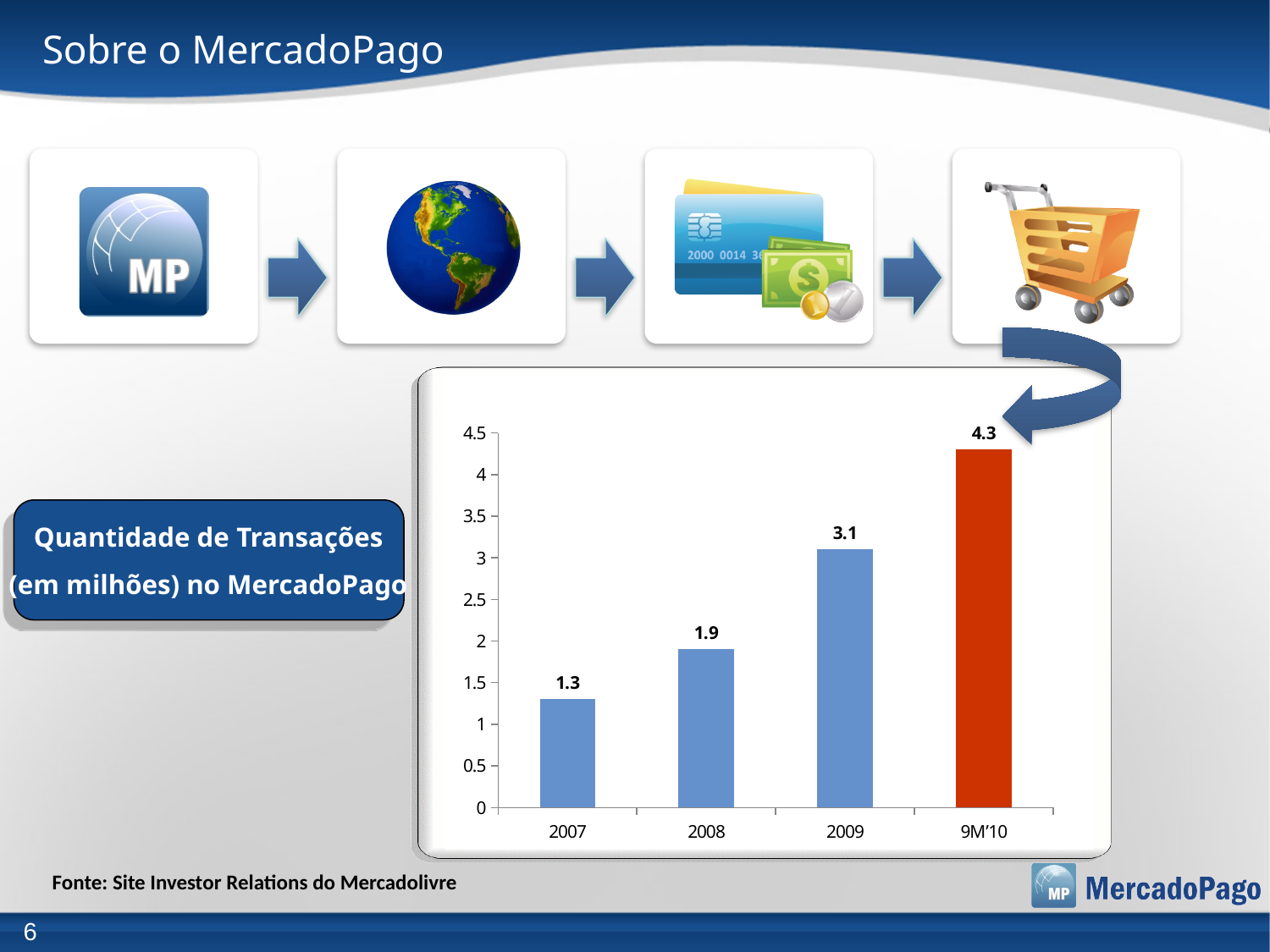
Which is larger, the value for 2009 or the value for 2008? 2009 Do the values rise or fall from 2007 to 9M'10? rise What is the value for 2008? 1.9 How many categories are shown on the x axis? 4 What is the difference between the values for 2008 and 2007? 0.6 Which category has the lowest value? 2007 What is the value for 9M'10? 4.3 What kind of chart is shown on the slide? bar chart Which category has the highest value? 9M'10 What is the value for 2009? 3.1 What is the value for 2007? 1.3 What is the difference between the values for 9M'10 and 2009? 1.2